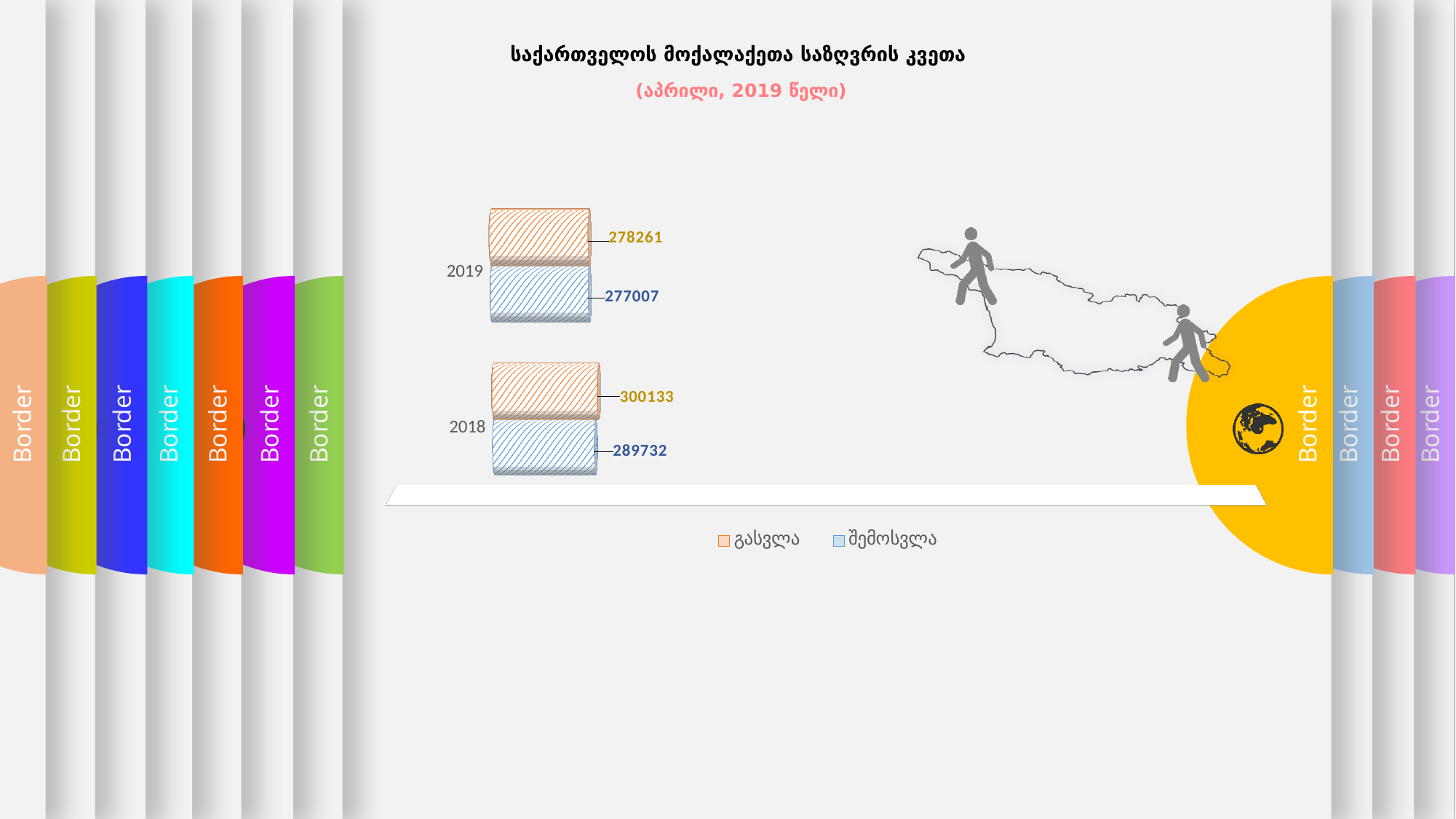
How many years are shown on the chart? 2 How many series does the legend list? 2 Which year has the higher value for გასვლა? 2018 What is the difference between the გასვლა values for 2018 and 2019? 21872 What is the value of გასვლა for 2019? 278261 What is the value of გასვლა for 2018? 300133 What is the value of შემოსვლა for 2019? 277007 What is the value of შემოსვლა for 2018? 289732 What kind of chart is shown on the slide? Bar chart Which year has the lower value for შემოსვლა? 2019 What is the difference between გასვლა and შემოსვლა in 2018? 10401 Which is larger in 2019, გასვლა or შემოსვლა? გასვლა